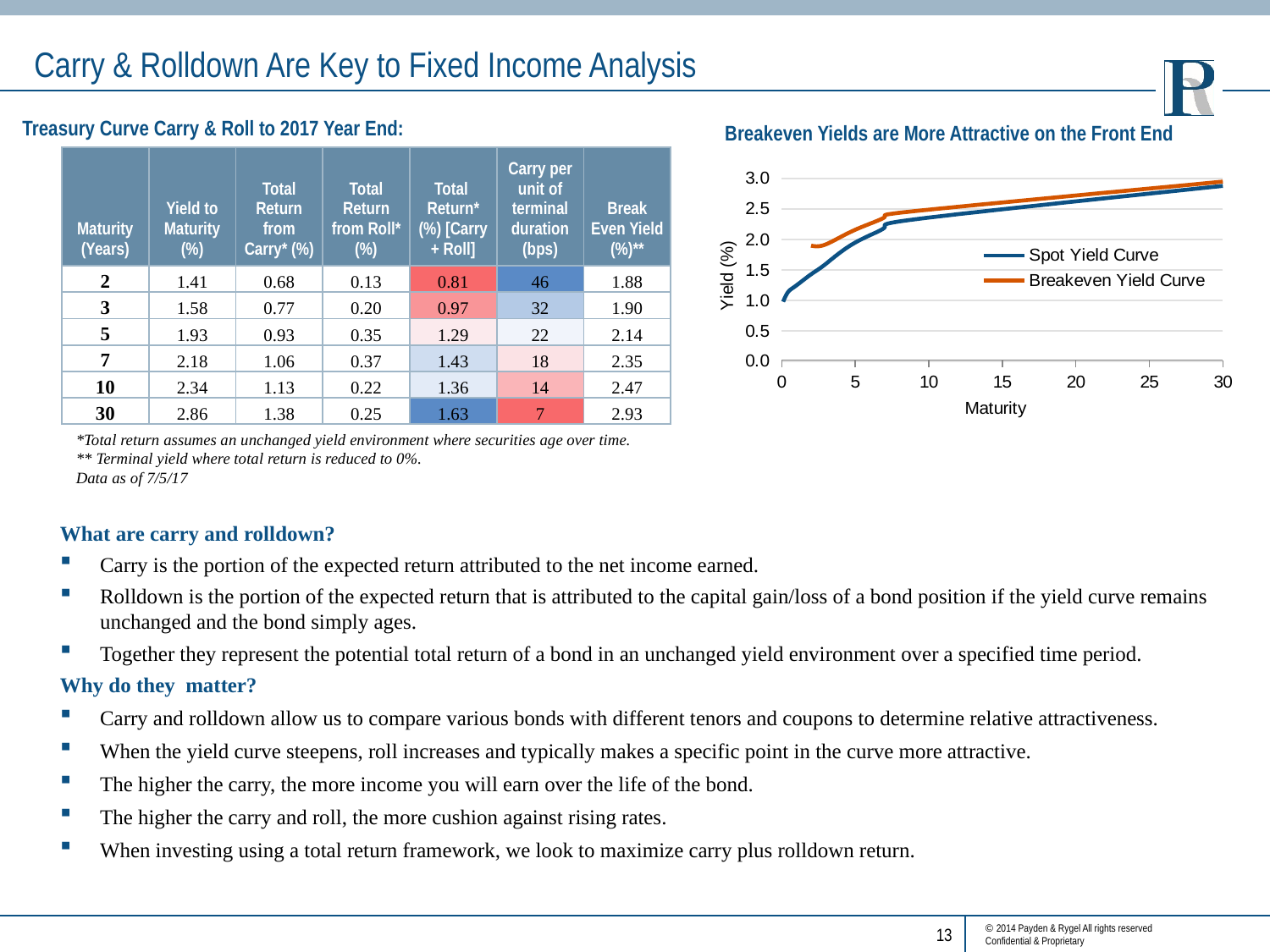
How many series does the chart's legend list? 2 What kind of chart is shown on the slide? line chart Is the value of the Breakeven Yield Curve at a maturity of 30 greater or less than 2.5? greater Does the Spot Yield Curve rise or fall as maturity increases? rise Is the value of the Breakeven Yield Curve at a maturity of 20 greater or less than 2.0? greater What is the title of the chart on the right side of the slide? Breakeven Yields are More Attractive on the Front End Is the value of the Spot Yield Curve at a maturity of 30 greater or less than 2.5? greater At a maturity of 5 years, which curve is higher, the Spot Yield Curve or the Breakeven Yield Curve? Breakeven Yield Curve Does the Breakeven Yield Curve rise or fall as maturity increases? rise Which series in the chart is drawn in orange? Breakeven Yield Curve